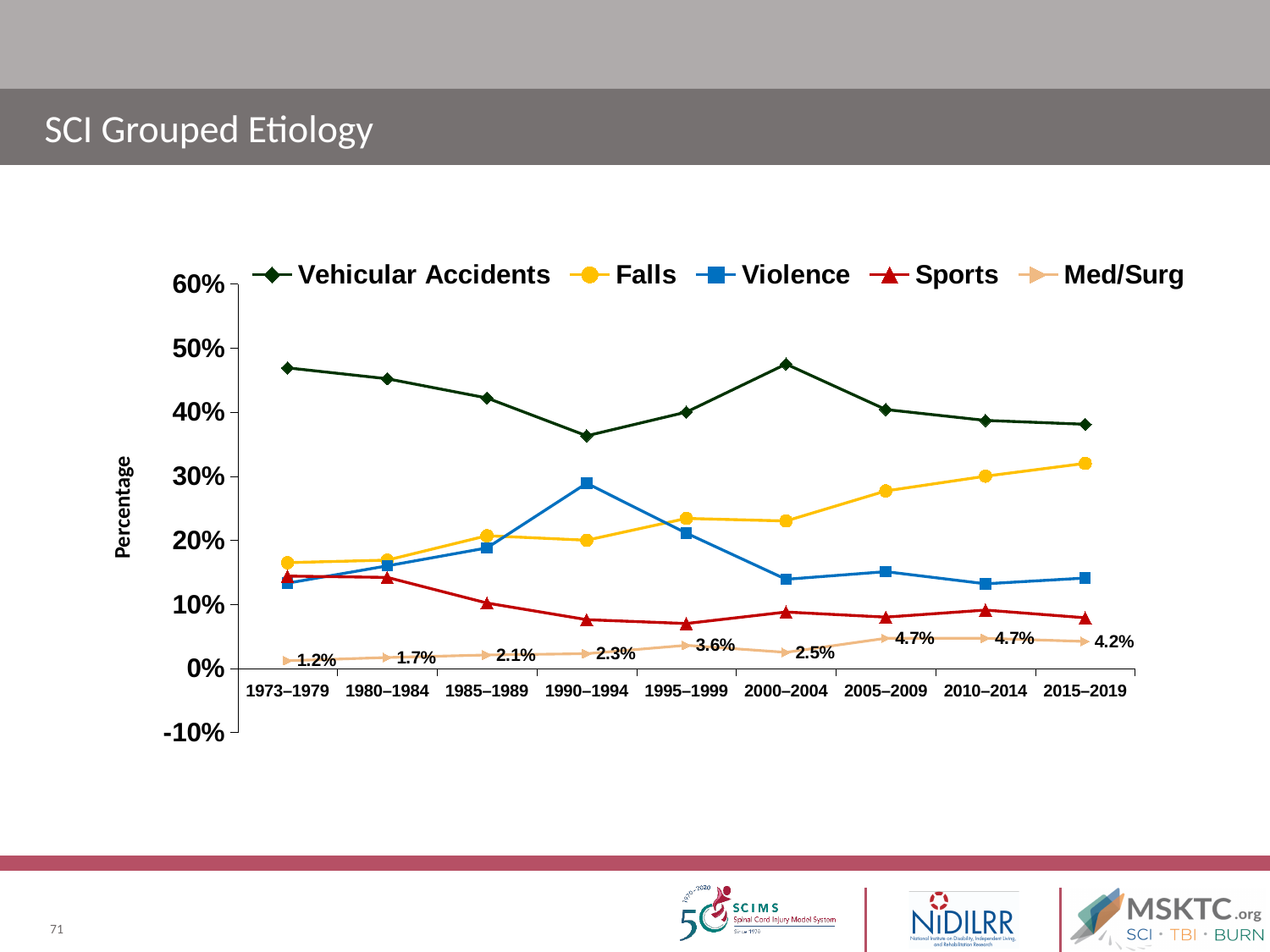
What is the Med/Surg value for 2015–2019? 4.2% In 2015–2019, which is larger: Vehicular Accidents or Falls? Vehicular Accidents What is the difference between the Med/Surg values for 2015–2019 and 1973–1979? 3.0% How many series does the legend list? 5 What is the Med/Surg value for 1973–1979? 1.2% Does the Falls series generally rise or fall from 1973–1979 to 2015–2019? rise Is the value for Vehicular Accidents in 1973–1979 greater or less than 40%? greater How many time periods are shown on the x axis? 9 What is the Med/Surg value for 1995–1999? 3.6% In which period is the Med/Surg value lowest? 1973–1979 What kind of chart is shown on the slide? line chart Is the value for Violence in 1990–1994 greater or less than 20%? greater